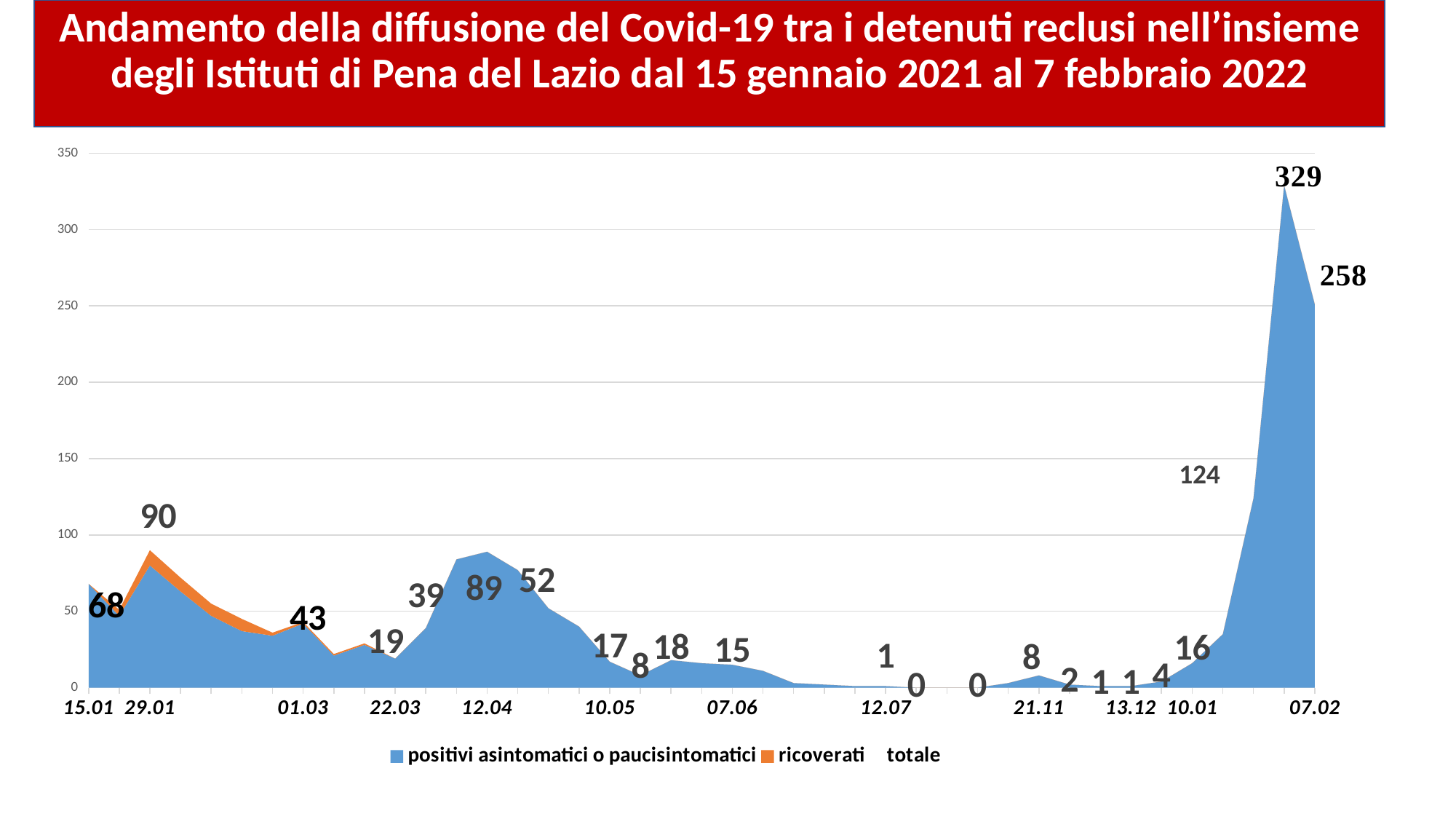
What is the lowest value labelled on the chart? 0 What is the value labelled at 15.01? 68 Which date has the larger labelled value, 15.01 or 29.01? 29.01 How many series does the legend list? 3 What kind of chart is shown on the slide? area chart What is the value labelled at 07.02? 258 What is the value labelled at 12.04? 89 What is the highest value labelled on the chart? 329 Is the value at 07.02 greater or less than 250? greater What is the difference between the peak value of 329 and the final value of 258? 71 What is the value labelled at 29.01? 90 Which colour represents the 'ricoverati' series in the legend? orange